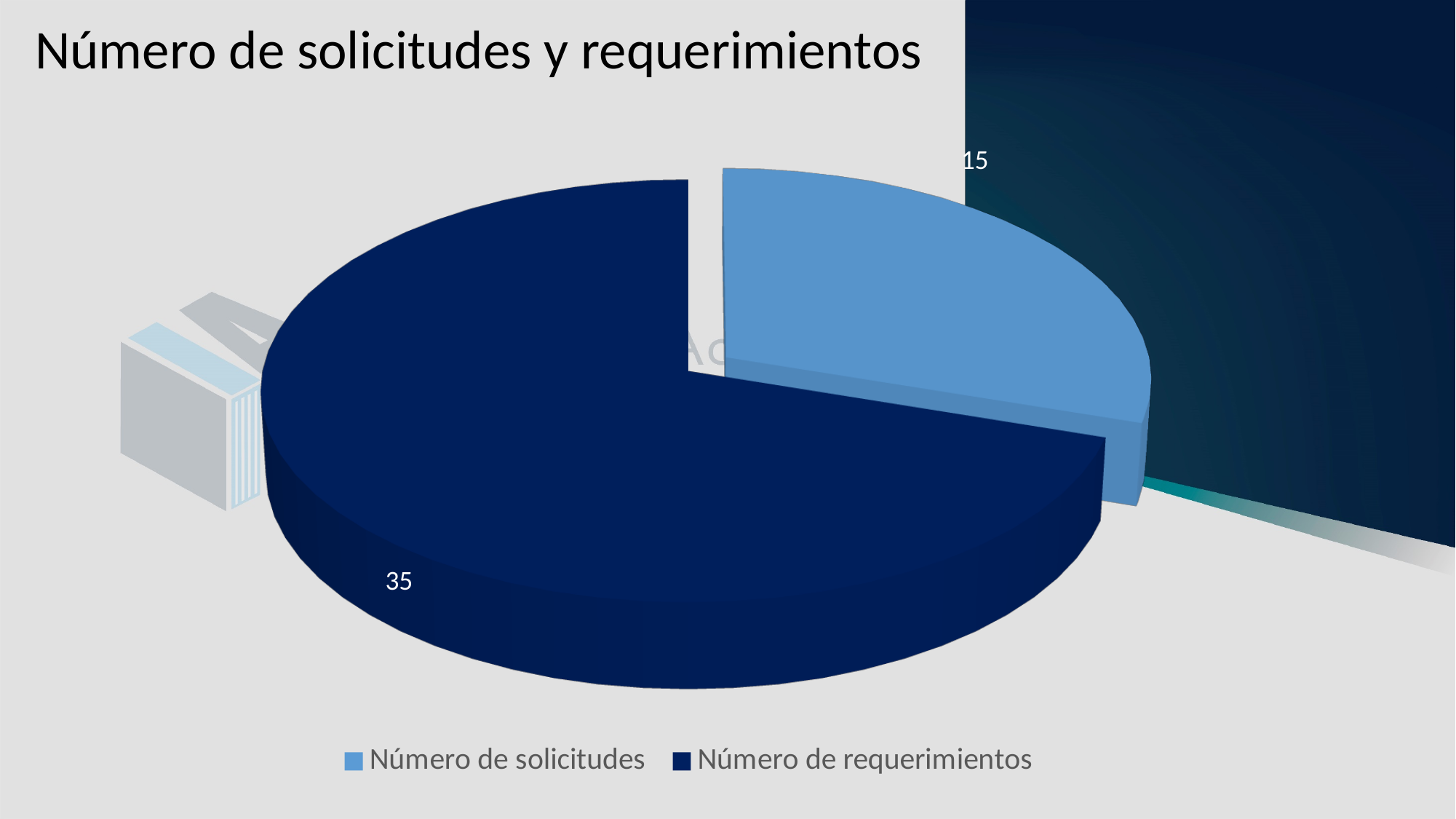
What kind of chart is shown on the slide? Pie chart What is the value for Número de solicitudes? 15 What is the title of the chart? Número de solicitudes y requerimientos What is the total of the two slices in the pie chart? 50 What is the difference between Número de requerimientos and Número de solicitudes? 20 How many entries does the legend list? 2 Which is larger, Número de solicitudes or Número de requerimientos? Número de requerimientos Which category has the largest slice of the pie? Número de requerimientos What share of the pie does Número de requerimientos represent? 70% Which category has the smallest slice of the pie? Número de solicitudes How many slices does the pie chart have? 2 What is the value for Número de requerimientos? 35